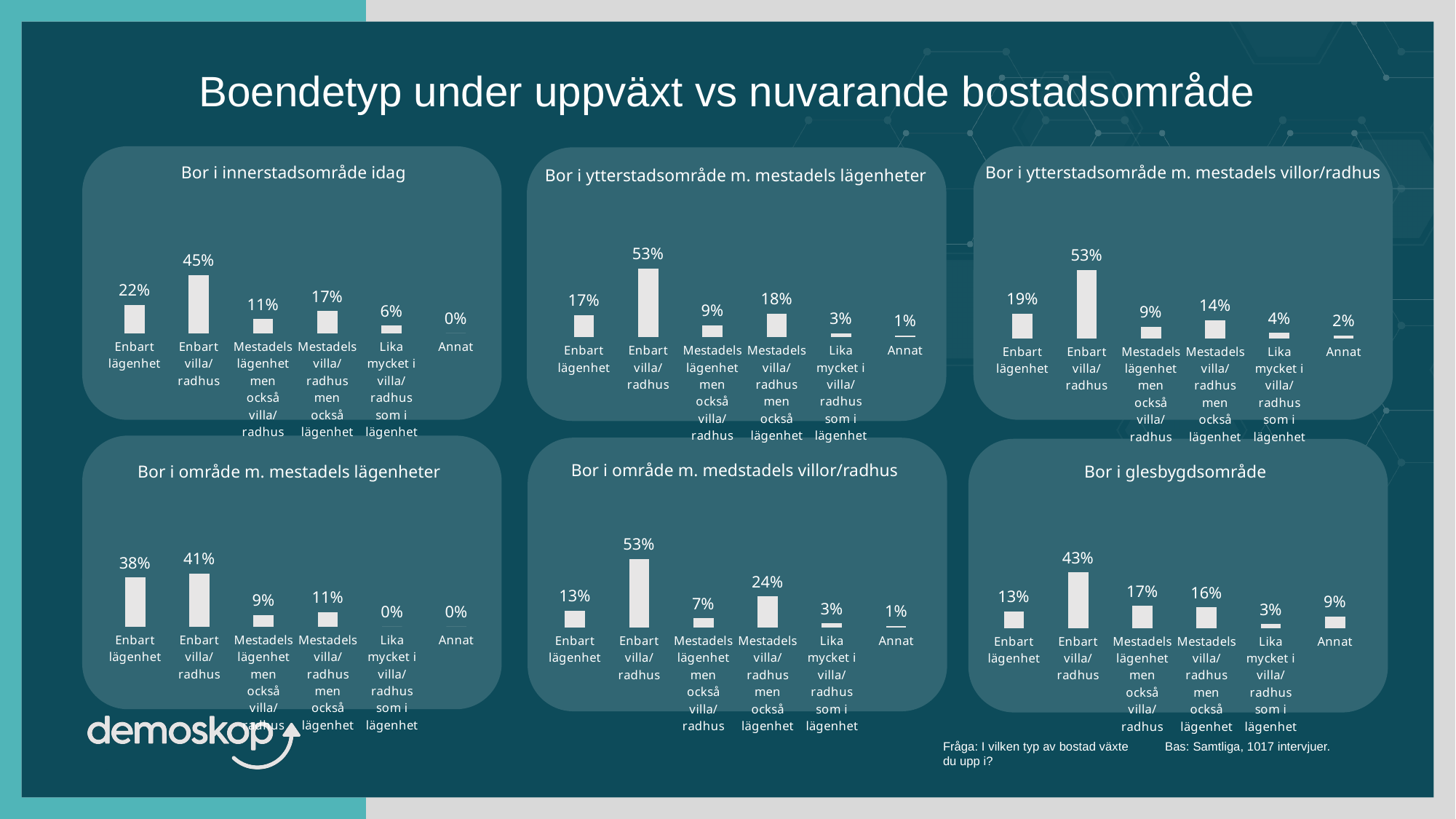
In the chart titled "Bor i ytterstadsområde m. mestadels villor/radhus", which category has the lowest value? Annat What kind of chart is "Bor i ytterstadsområde m. mestadels lägenheter"? Bar chart How many charts are shown on the slide? 6 In the chart titled "Bor i område m. mestadels lägenheter", what is the difference between "Enbart villa/radhus" and "Enbart lägenhet"? 3 percentage points How many categories are shown in the chart titled "Bor i innerstadsområde idag"? 6 In the chart titled "Bor i ytterstadsområde m. mestadels lägenheter", what is the value for "Mestadels villa/radhus men också lägenhet"? 18% In the chart titled "Bor i glesbygdsområde", what is the value for "Annat"? 9% In the chart titled "Bor i ytterstadsområde m. mestadels villor/radhus", what is the value for "Lika mycket i villa/radhus som i lägenhet"? 4% In the chart titled "Bor i innerstadsområde idag", what is the difference between "Enbart lägenhet" and "Mestadels villa/radhus men också lägenhet"? 5 percentage points In the chart titled "Bor i område m. medstadels villor/radhus", which category has the highest value? Enbart villa/radhus In the chart titled "Bor i glesbygdsområde", which is larger: "Mestadels lägenhet men också villa/radhus" or "Mestadels villa/radhus men också lägenhet"? Mestadels lägenhet men också villa/radhus In the chart titled "Bor i innerstadsområde idag", what is the value for "Enbart villa/radhus"? 45%